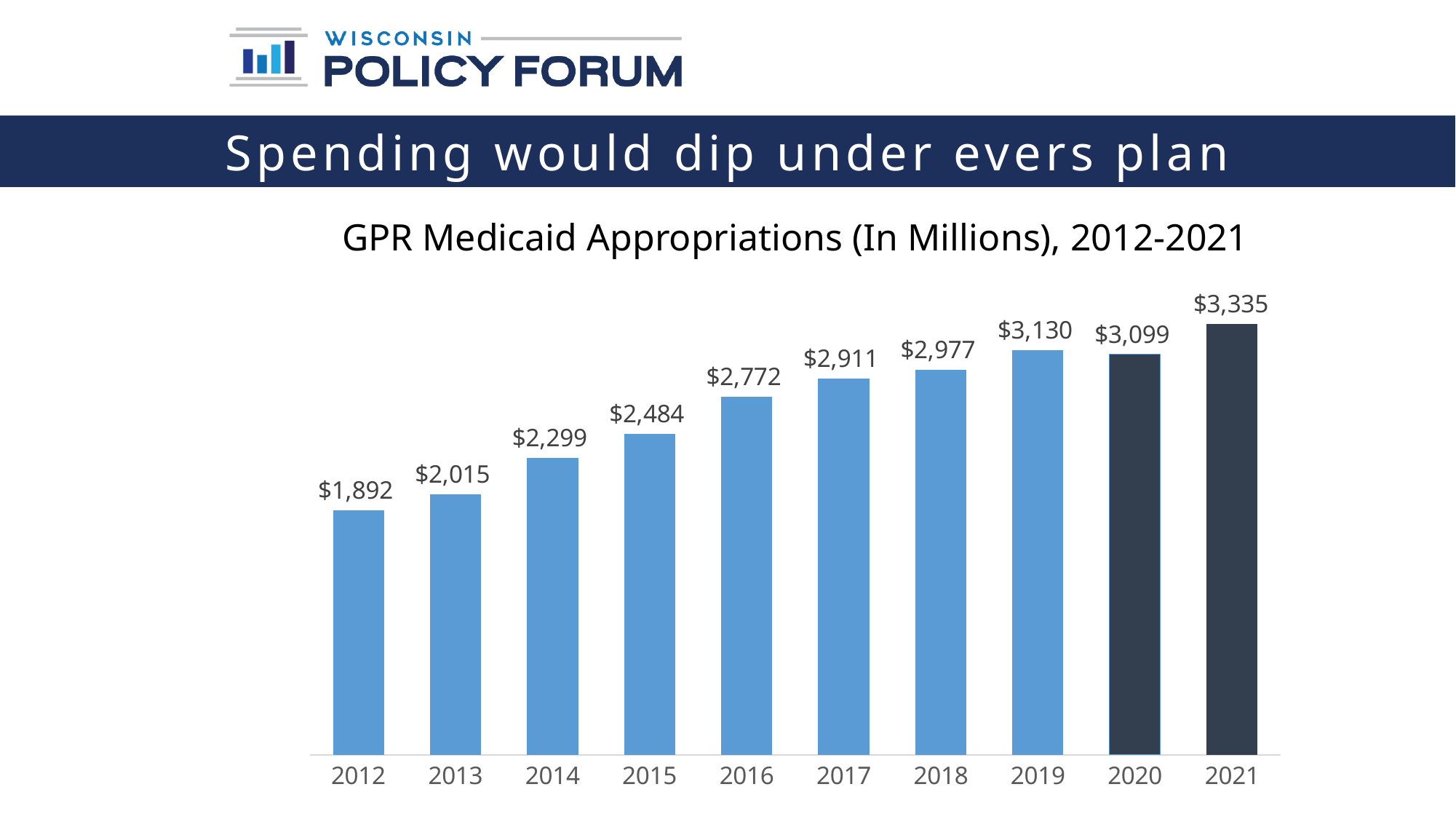
Do the appropriations generally rise or fall from 2012 to 2019? Rise What kind of chart is shown on the slide? Bar chart Which year has a larger appropriation, 2019 or 2020? 2019 What is the title of the chart? GPR Medicaid Appropriations (In Millions), 2012-2021 What is the difference between the 2019 and 2020 appropriations? $31 Which year has the highest GPR Medicaid appropriation? 2021 What is the GPR Medicaid appropriation for 2016? $2,772 What is the difference between the 2021 and 2020 appropriations? $236 What is the GPR Medicaid appropriation for 2020? $3,099 What is the GPR Medicaid appropriation for 2012? $1,892 How many years are shown on the chart? 10 Which year has the lowest GPR Medicaid appropriation? 2012